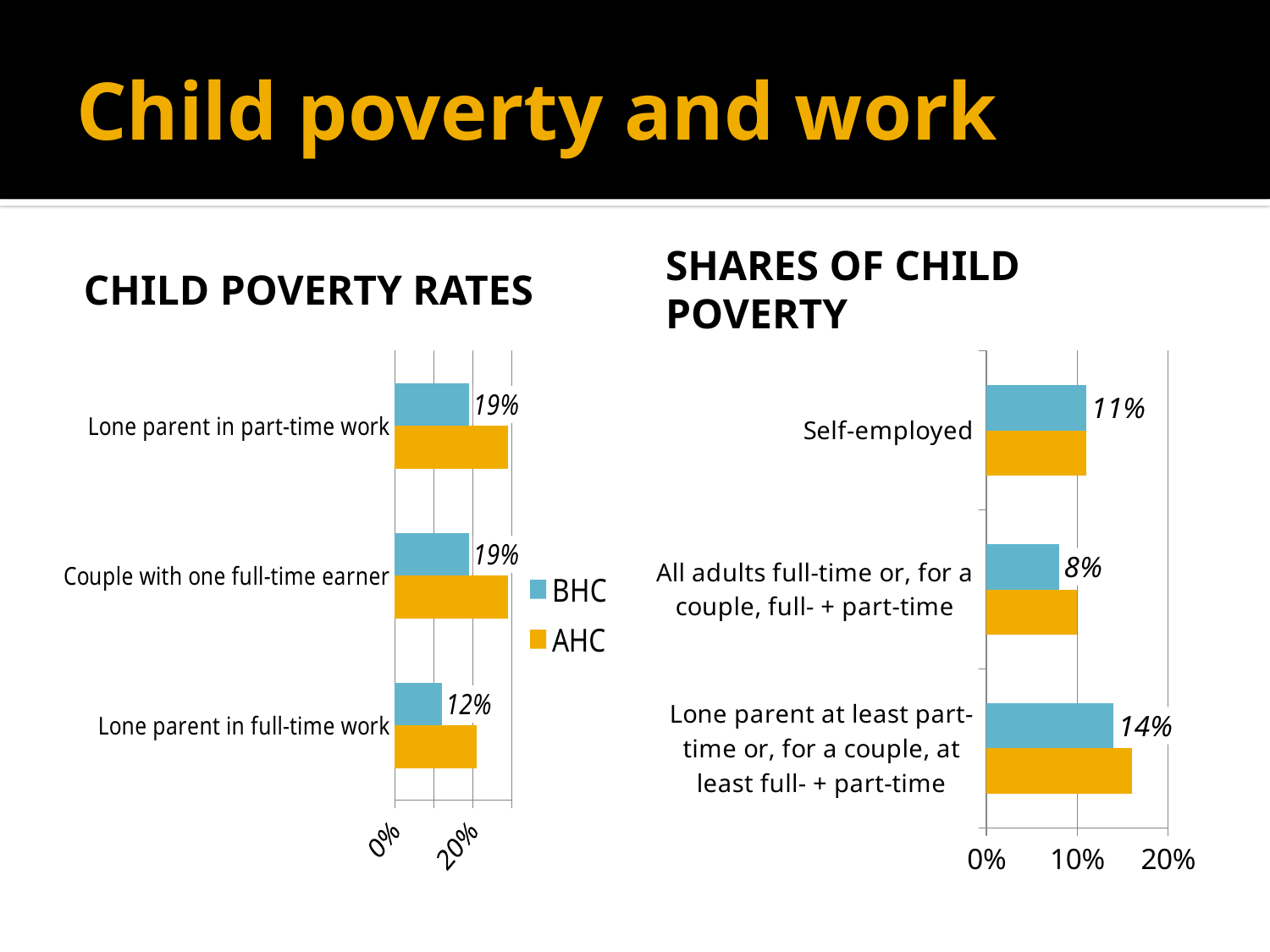
In the CHILD POVERTY RATES chart, what is the BHC value for Couple with one full-time earner? 19% In the SHARES OF CHILD POVERTY chart, what is the BHC value for Self-employed? 11% In the SHARES OF CHILD POVERTY chart, is the AHC value for Lone parent at least part-time or, for a couple, at least full- + part-time greater or less than 10%? greater What kind of chart is the SHARES OF CHILD POVERTY chart? bar chart How many series does the legend on the CHILD POVERTY RATES chart list? 2 In the CHILD POVERTY RATES chart, which category has the lowest BHC value? Lone parent in full-time work In the CHILD POVERTY RATES chart, what is the BHC value for Lone parent in full-time work? 12% In the CHILD POVERTY RATES chart, is the AHC value for Lone parent in part-time work greater or less than 20%? greater In the SHARES OF CHILD POVERTY chart, what is the BHC value for All adults full-time or, for a couple, full- + part-time? 8% In the CHILD POVERTY RATES chart, what is the difference between the BHC values for Lone parent in part-time work and Lone parent in full-time work? 7% In the SHARES OF CHILD POVERTY chart, which category has the highest BHC value? Lone parent at least part-time or, for a couple, at least full- + part-time In the SHARES OF CHILD POVERTY chart, what is the difference between the BHC values for Lone parent at least part-time and Self-employed? 3%